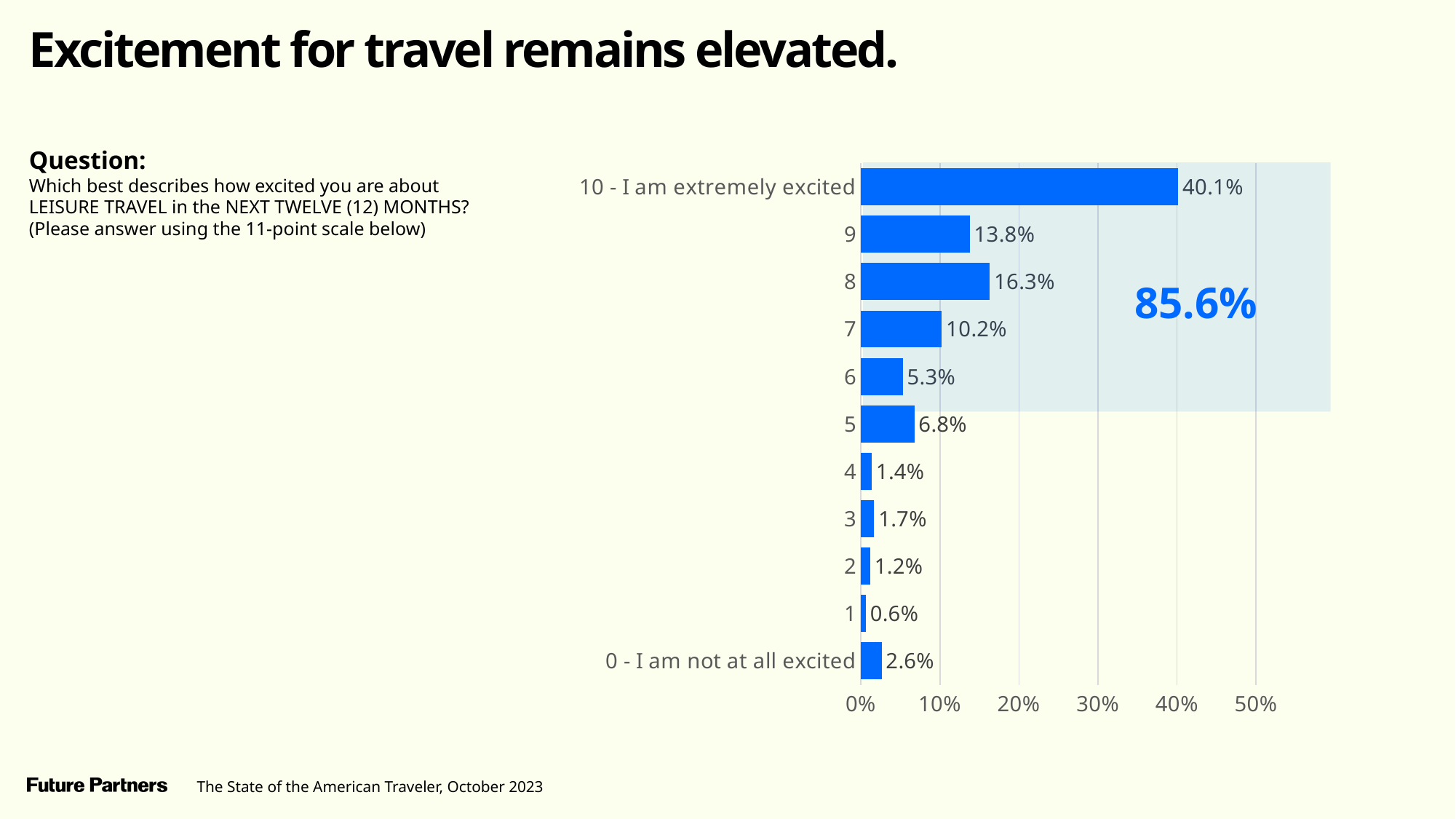
What is the value shown for the rating of 8? 16.3% How many rating categories are shown on the chart? 11 What is the highest value labelled on the horizontal axis? 50% Which rating category has the lowest value? 1 What is the combined percentage highlighted in the shaded area for ratings 6 through 10? 85.6% Is the value for rating 9 greater or less than 10%? greater What kind of chart is shown on the slide? Bar chart What percentage of respondents chose "10 - I am extremely excited"? 40.1% What percentage of respondents chose "0 - I am not at all excited"? 2.6% Which rating category has the highest value? 10 - I am extremely excited What is the difference between the values for rating 8 and rating 9? 2.5% Which has a larger value, rating 7 or rating 6? 7